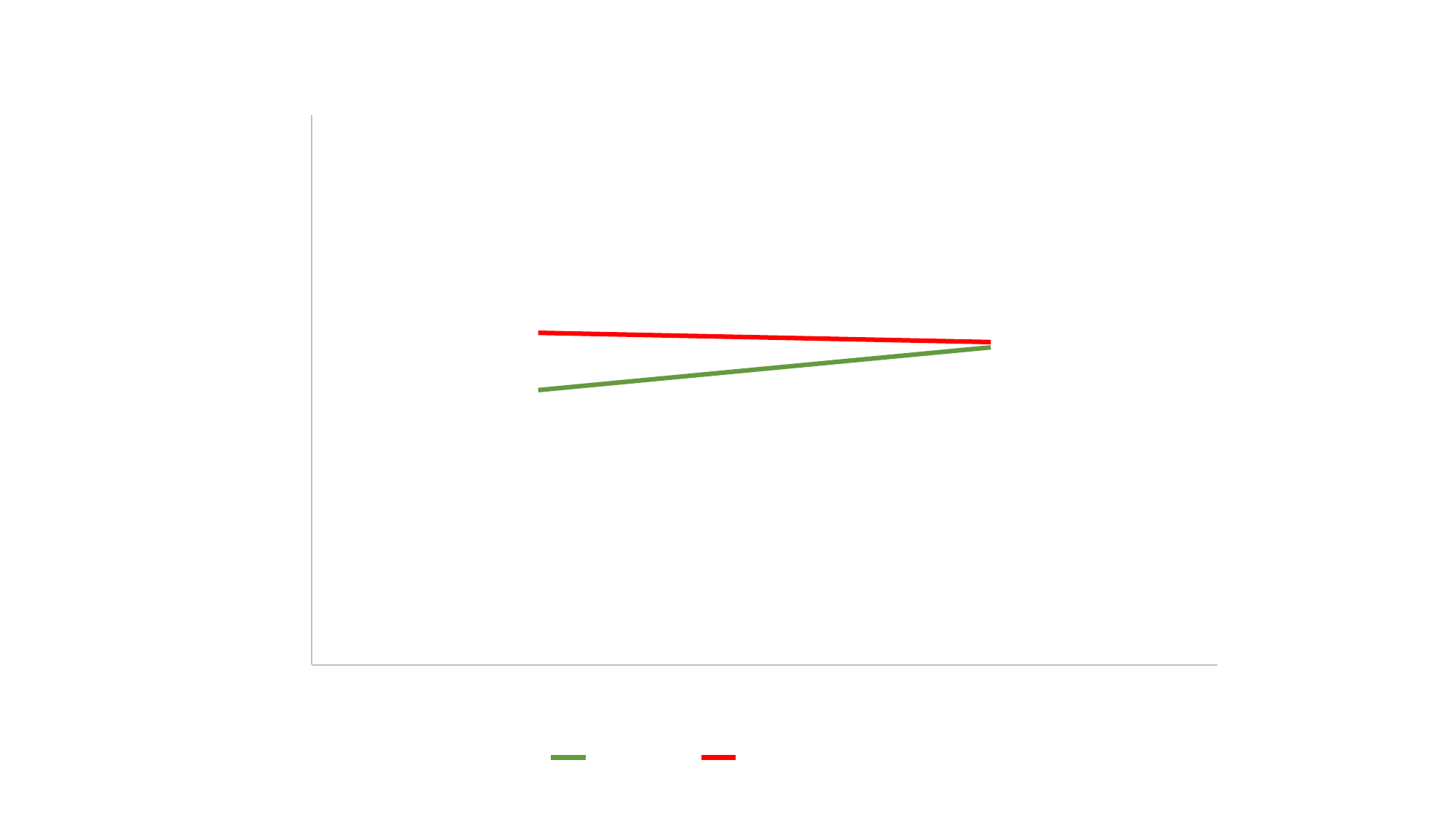
Does the green line rise or fall from left to right? rises What colours are the two lines on the chart? green and red How many lines are plotted on the chart? 2 At the left end of the lines, which line is higher, the red line or the green line? the red line Does the red line rise or fall from left to right? falls How many series does the legend list? 2 What kind of chart is shown on the slide? line chart